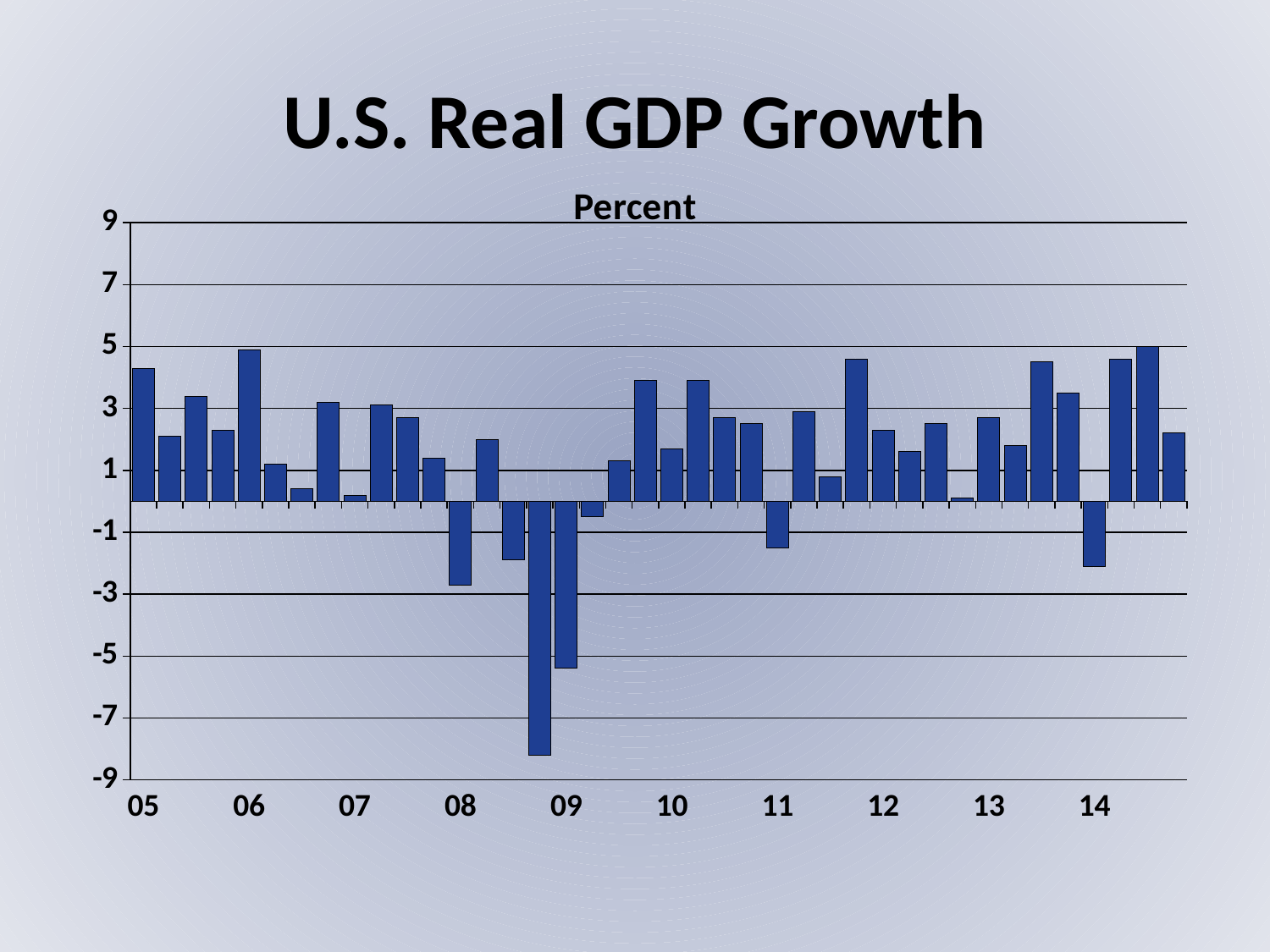
How many year labels are shown along the x axis? 10 Is the value of the lowest bar on the chart greater or less than -7? less What unit label is shown above the vertical axis? Percent Is the value of the first bar (at the 05 label) greater or less than 3? greater What is the title of the chart? U.S. Real GDP Growth What kind of chart is shown on the slide? bar chart Is the value of the bar directly above the 09 label greater or less than -3? less What is the highest value shown on the vertical axis? 9 Which is larger: the bar directly above the 05 label or the bar directly above the 07 label? the bar above 05 In which year does the lowest bar on the chart occur? 08